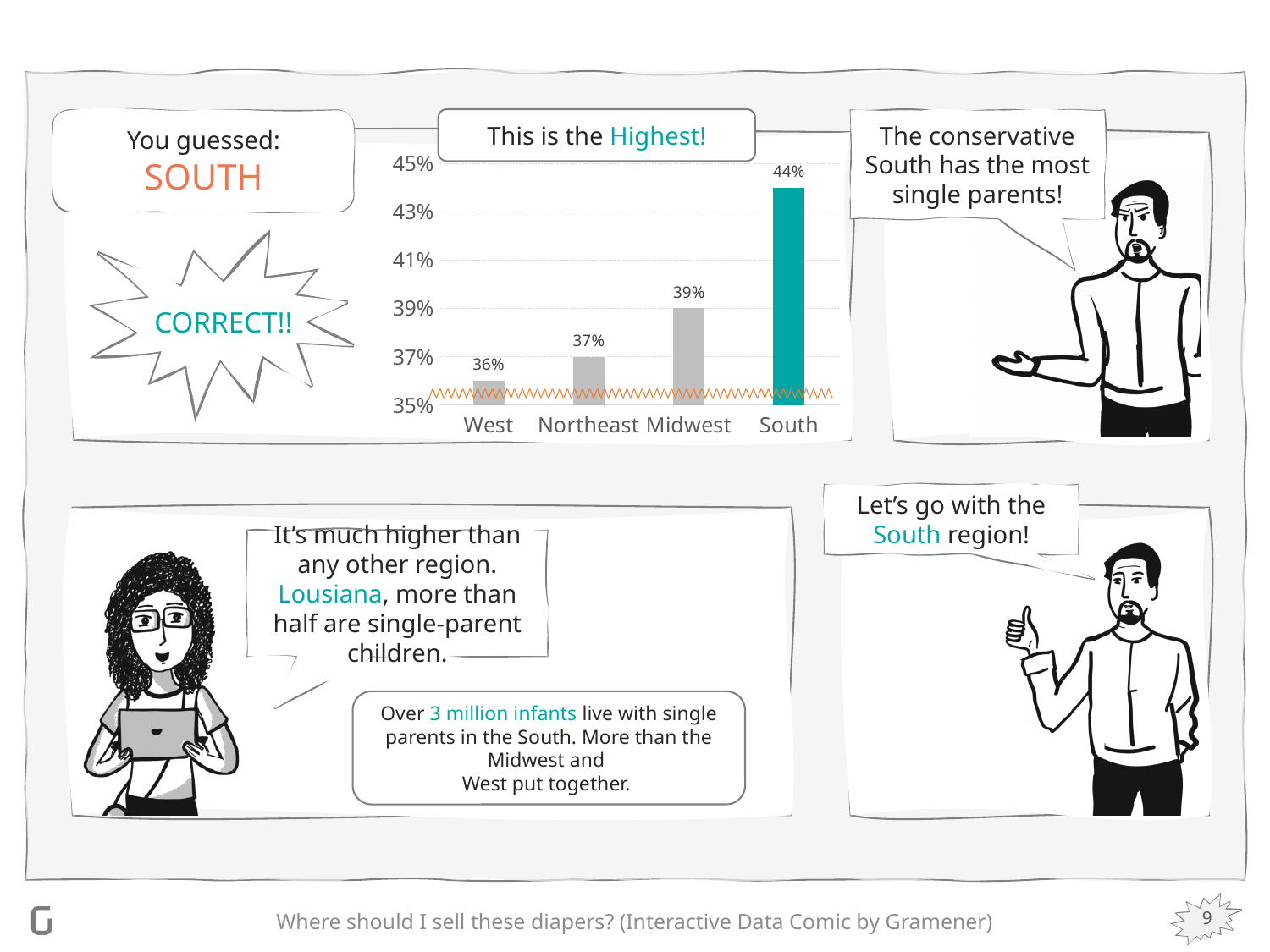
How many regions are shown on the chart? 4 What is the value for Northeast? 37% What is the difference between the values for Northeast and West? 1% What kind of chart is shown? bar chart What is the value for West? 36% Which bar is coloured differently from the others? South Which is larger, the value for Midwest or the value for Northeast? Midwest What is the value for Midwest? 39% Which region has the lowest value? West What is the difference between the values for South and Midwest? 5% What is the value for South? 44% Which region has the highest value? South